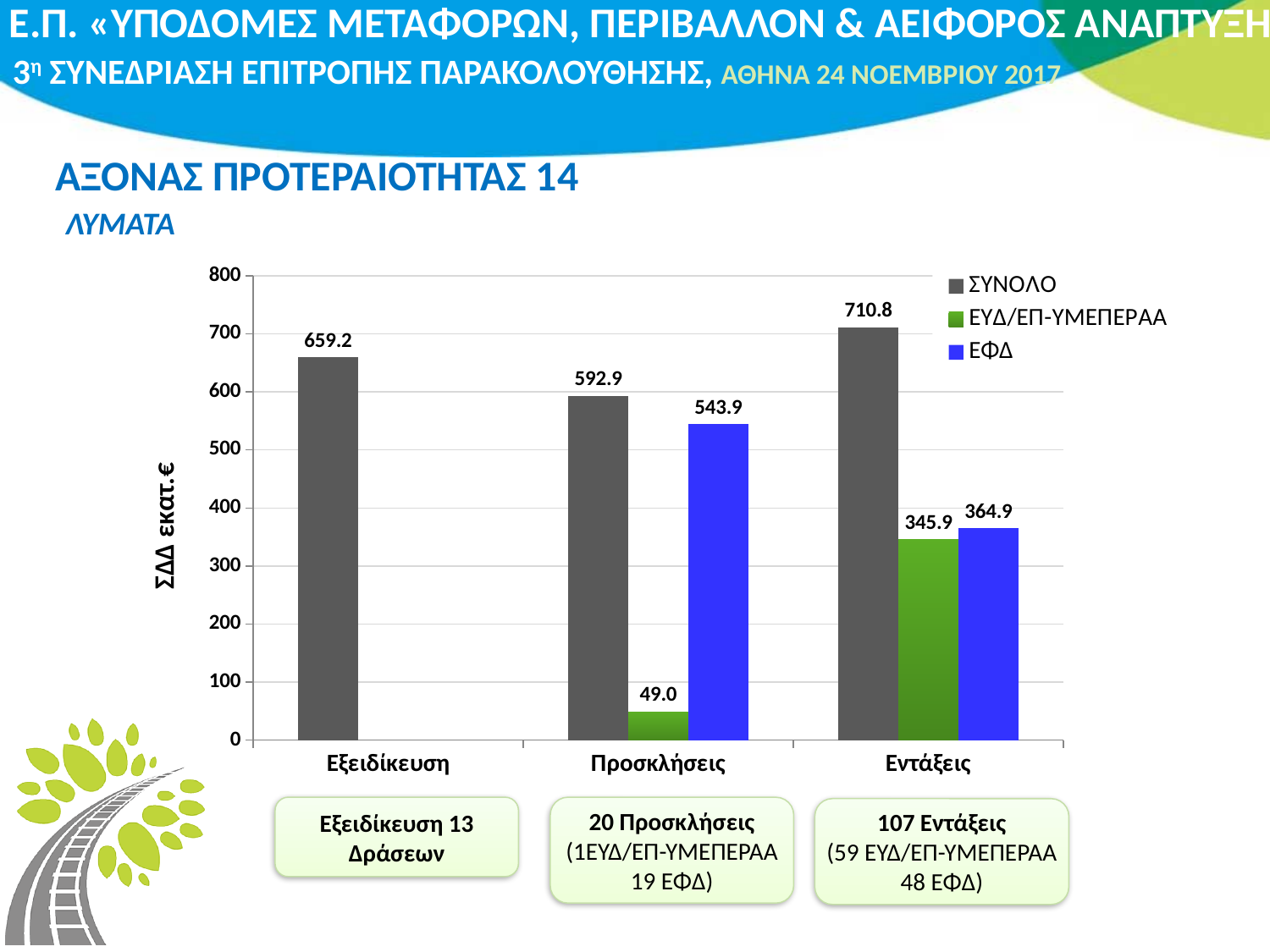
Which is larger for Εντάξεις: the ΕΥΔ/ΕΠ-ΥΜΕΠΕΡΑΑ value or the ΕΦΔ value? ΕΦΔ Is the ΣΥΝΟΛΟ value for Εντάξεις greater or less than 700? greater How many categories are shown on the x axis? 3 What is the ΕΦΔ value for Προσκλήσεις? 543.9 Which category has the highest ΣΥΝΟΛΟ value? Εντάξεις What is the label of the vertical axis? ΣΔΔ εκατ.€ How many series does the legend list? 3 What is the difference between the ΣΥΝΟΛΟ values for Εντάξεις and Προσκλήσεις? 117.9 Which category has the lowest ΕΥΔ/ΕΠ-ΥΜΕΠΕΡΑΑ value? Προσκλήσεις What kind of chart is shown on the slide? bar chart What is the ΣΥΝΟΛΟ value for Εξειδίκευση? 659.2 What is the ΕΥΔ/ΕΠ-ΥΜΕΠΕΡΑΑ value for Εντάξεις? 345.9